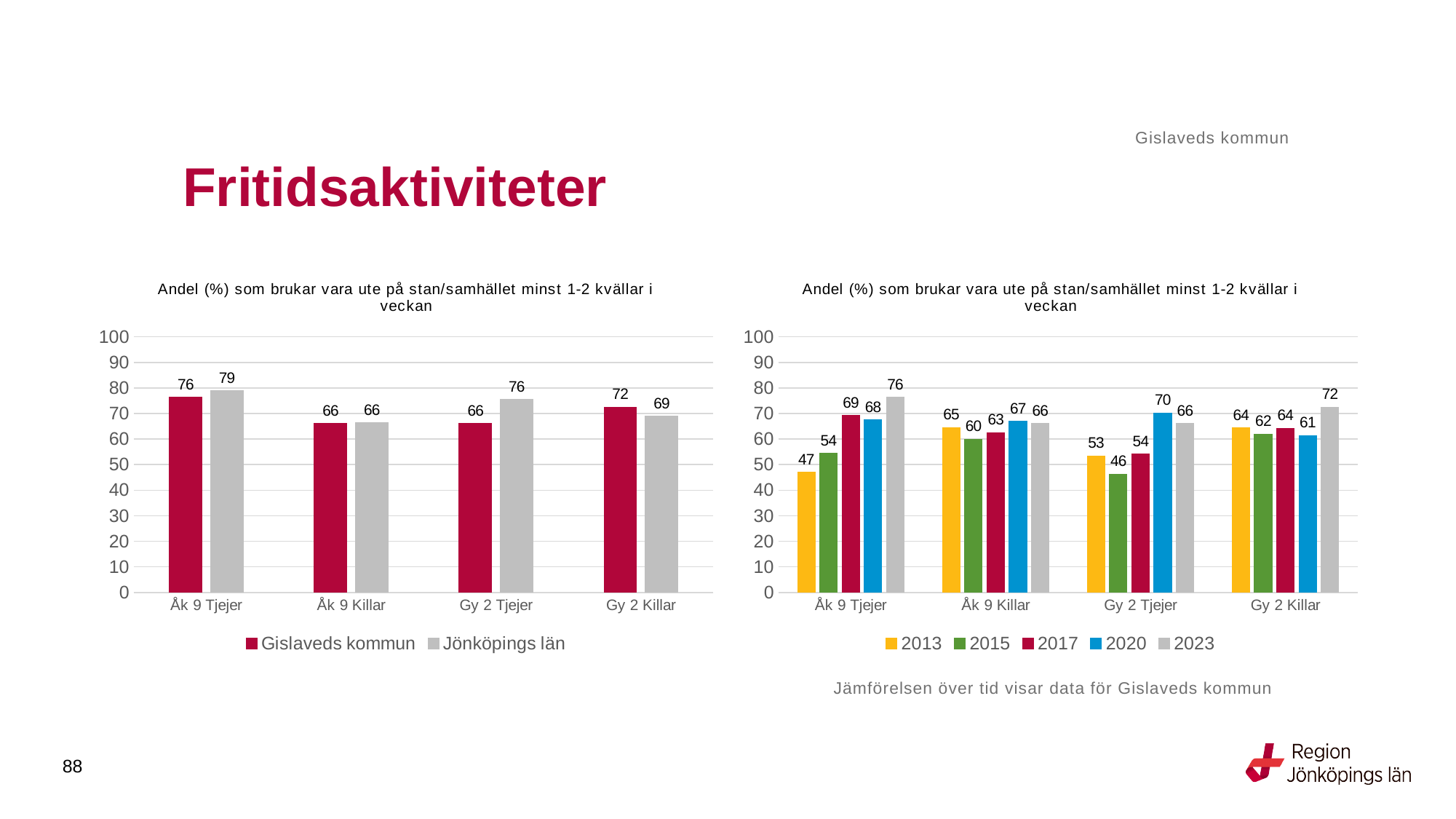
In the right chart, what is the value for 2013 for Åk 9 Tjejer? 47 In the left chart, how many series does the legend list? 2 In the right chart, which year has the highest value for Gy 2 Killar? 2023 In the right chart, what is the value for 2020 for Gy 2 Tjejer? 70 In the left chart, what is the difference between Jönköpings län and Gislaveds kommun for Gy 2 Tjejer? 10 In the left chart, what is the value for Jönköpings län for Gy 2 Tjejer? 76 In the right chart, is the 2023 value for Åk 9 Tjejer larger or the 2023 value for Gy 2 Killar? Åk 9 Tjejer In the left chart, which category has the highest value for Gislaveds kommun? Åk 9 Tjejer In the right chart, which year has the lowest value for Gy 2 Tjejer? 2015 What kind of chart is the right chart? Bar chart In the left chart, what is the value for Gislaveds kommun for Gy 2 Killar? 72 In the right chart, how many series does the legend list? 5